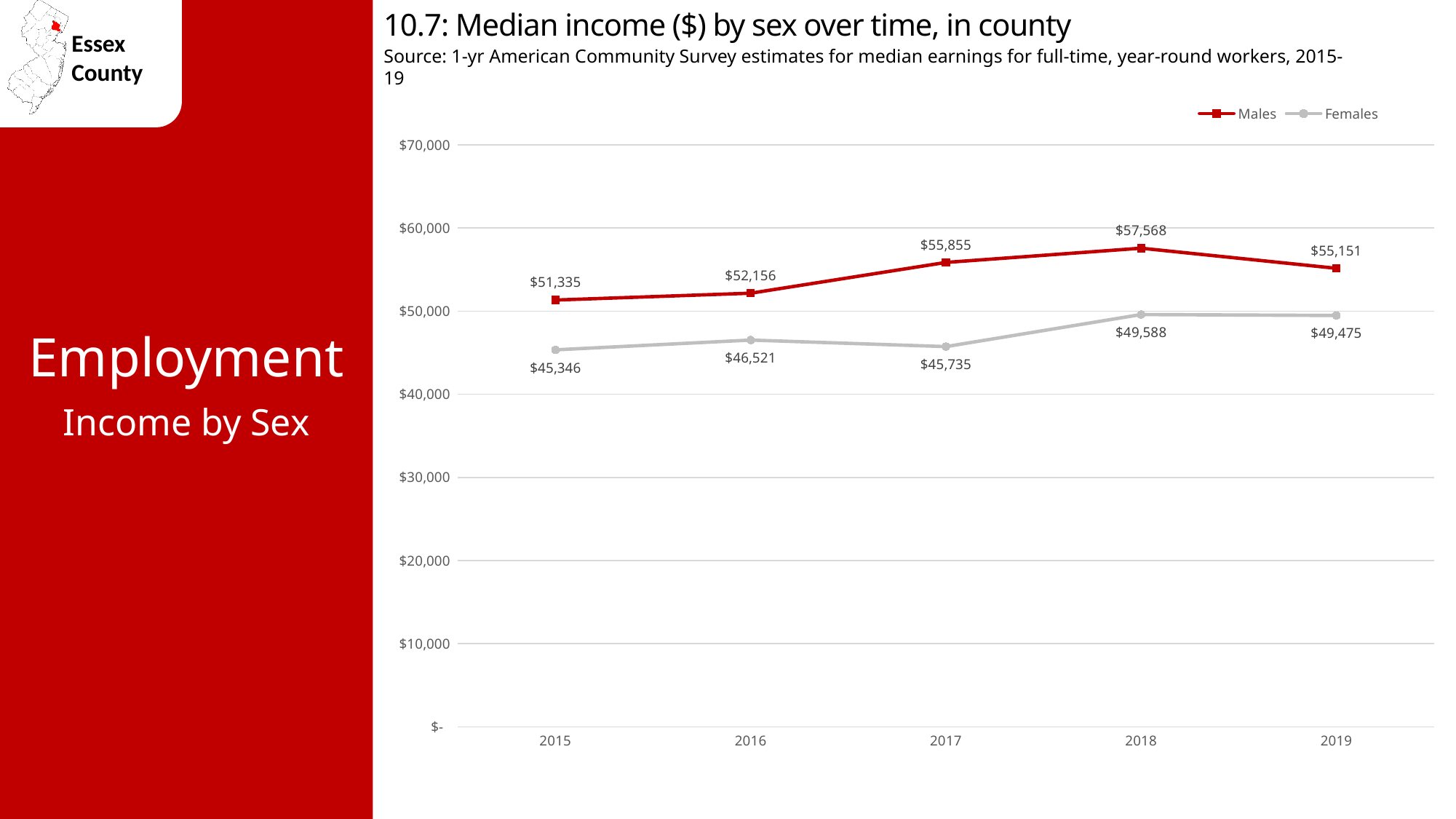
What was the median income for Females in 2017? $45,735 In which year was the median income for Males highest? 2018 What is the difference between the Males median income in 2018 and in 2015? $6,233 What is the difference between the Males and Females median income in 2019? $5,676 What kind of chart is shown on the slide? line chart In which year was the median income for Females lowest? 2015 Is the median income for Females in 2018 greater or less than $50,000? less What was the median income for Females in 2015? $45,346 What was the median income for Males in 2018? $57,568 Which was larger in 2016, the median income for Males or for Females? Males How many series does the legend list? 2 How many years are shown on the x axis? 5